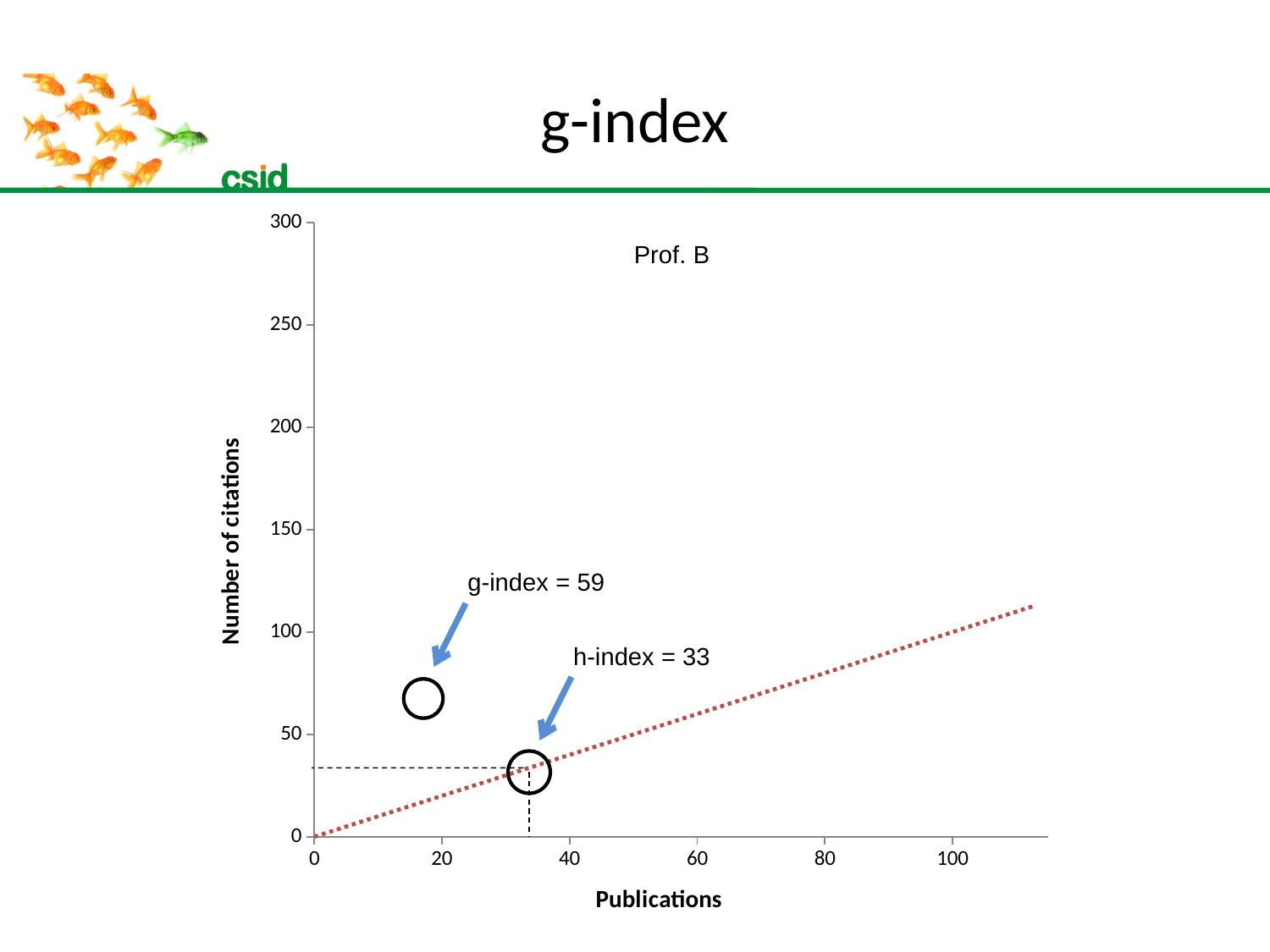
What h-index value is annotated on the chart? 33 How many circled points are marked on the chart? 2 Is the number of citations at the circled g-index point greater or less than 100? less What is the title of the y axis? Number of citations Which is larger, the g-index or the h-index shown on the chart? g-index Is the Publications value at the circled g-index point greater or less than 20? less Is the number of citations at the circled g-index point greater or less than 50? greater What is the title of the x axis? Publications Does the red dotted line rise or fall as Publications increase? rise What is the difference between the g-index and the h-index shown on the chart? 26 What g-index value is annotated on the chart? 59